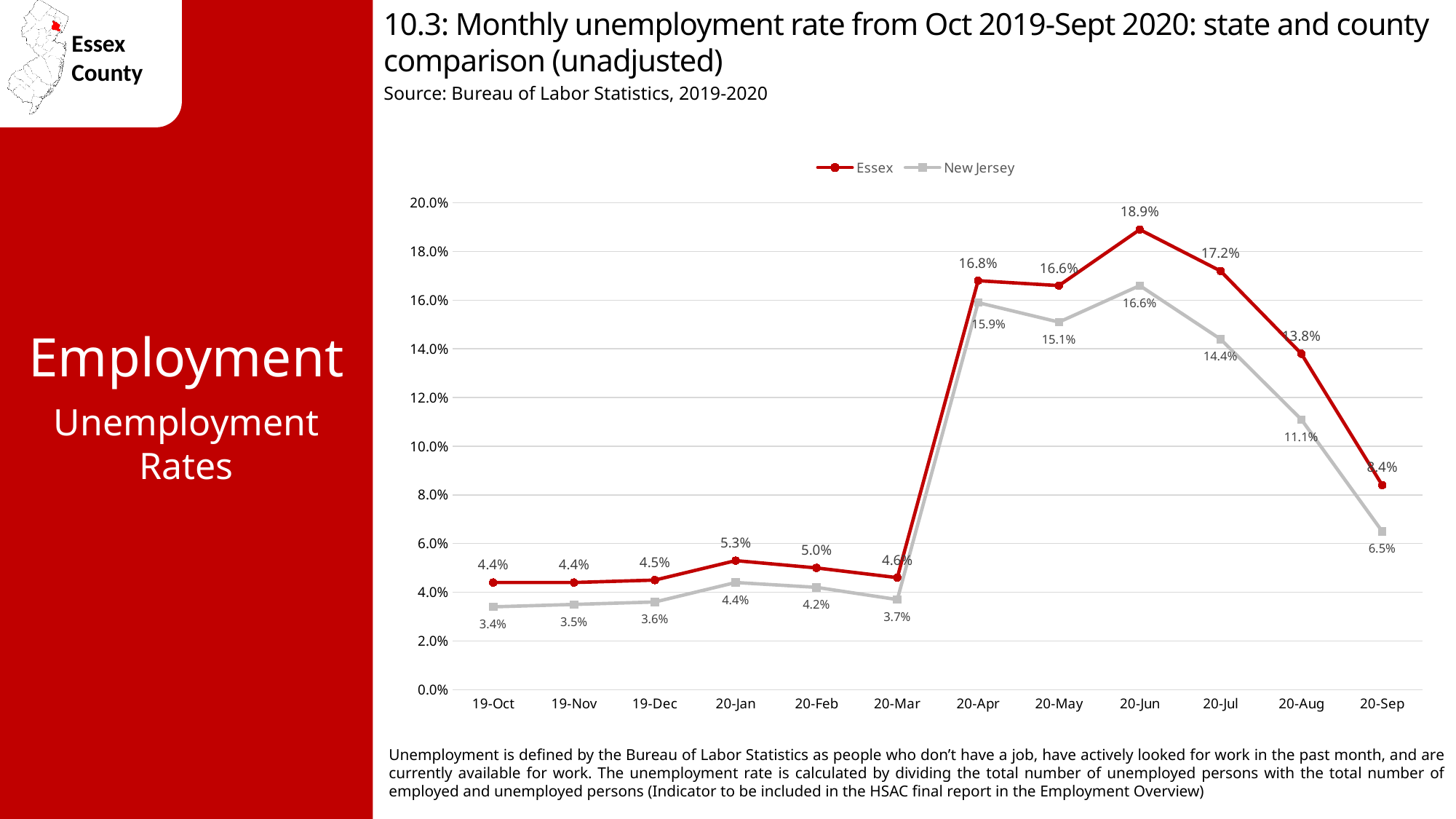
How many series does the legend list? 2 What was the New Jersey unemployment rate in 20-Jul? 14.4% How many months are plotted on the x axis? 12 What is the difference between the Essex and New Jersey unemployment rates in 20-Sep? 1.9% In which month was the New Jersey unemployment rate lowest? 19-Oct What is the source cited for the chart? Bureau of Labor Statistics, 2019-2020 Did the Essex unemployment rate rise or fall from 20-Jun to 20-Sep? Fall What type of chart is shown on the slide? Line chart In which month did the Essex unemployment rate reach its highest value? 20-Jun Which series had the higher unemployment rate in 20-Aug, Essex or New Jersey? Essex What was the Essex unemployment rate in 20-Jun? 18.9% What was the New Jersey unemployment rate in 20-Apr? 15.9%